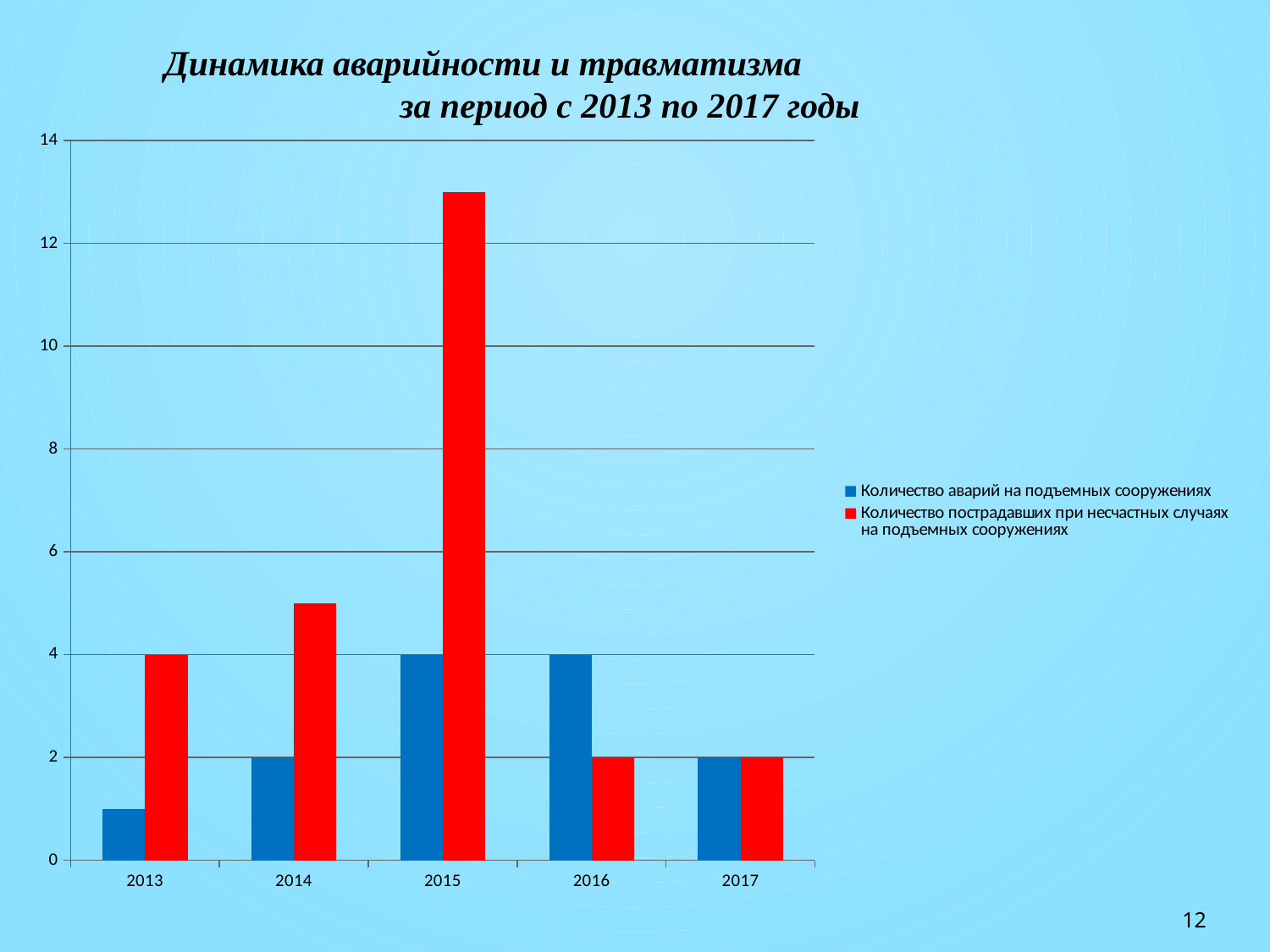
Which colour represents 'Количество пострадавших при несчастных случаях на подъемных сооружениях' in the legend? red How many years are shown on the x axis? 5 In 2016, which series has the larger value: 'Количество аварий на подъемных сооружениях' or 'Количество пострадавших при несчастных случаях на подъемных сооружениях'? Количество аварий на подъемных сооружениях What type of chart is shown on the slide? bar chart What is the value for 'Количество аварий на подъемных сооружениях' in 2015? 4 What is the value for 'Количество пострадавших при несчастных случаях на подъемных сооружениях' in 2013? 4 Is the value for 'Количество пострадавших при несчастных случаях на подъемных сооружениях' in 2015 greater or less than 12? greater Is the value for 'Количество аварий на подъемных сооружениях' in 2013 greater or less than 2? less How many series does the legend list? 2 Which year has the highest value for 'Количество пострадавших при несчастных случаях на подъемных сооружениях'? 2015 Which year has the lowest value for 'Количество аварий на подъемных сооружениях'? 2013 What is the value for 'Количество аварий на подъемных сооружениях' in 2017? 2